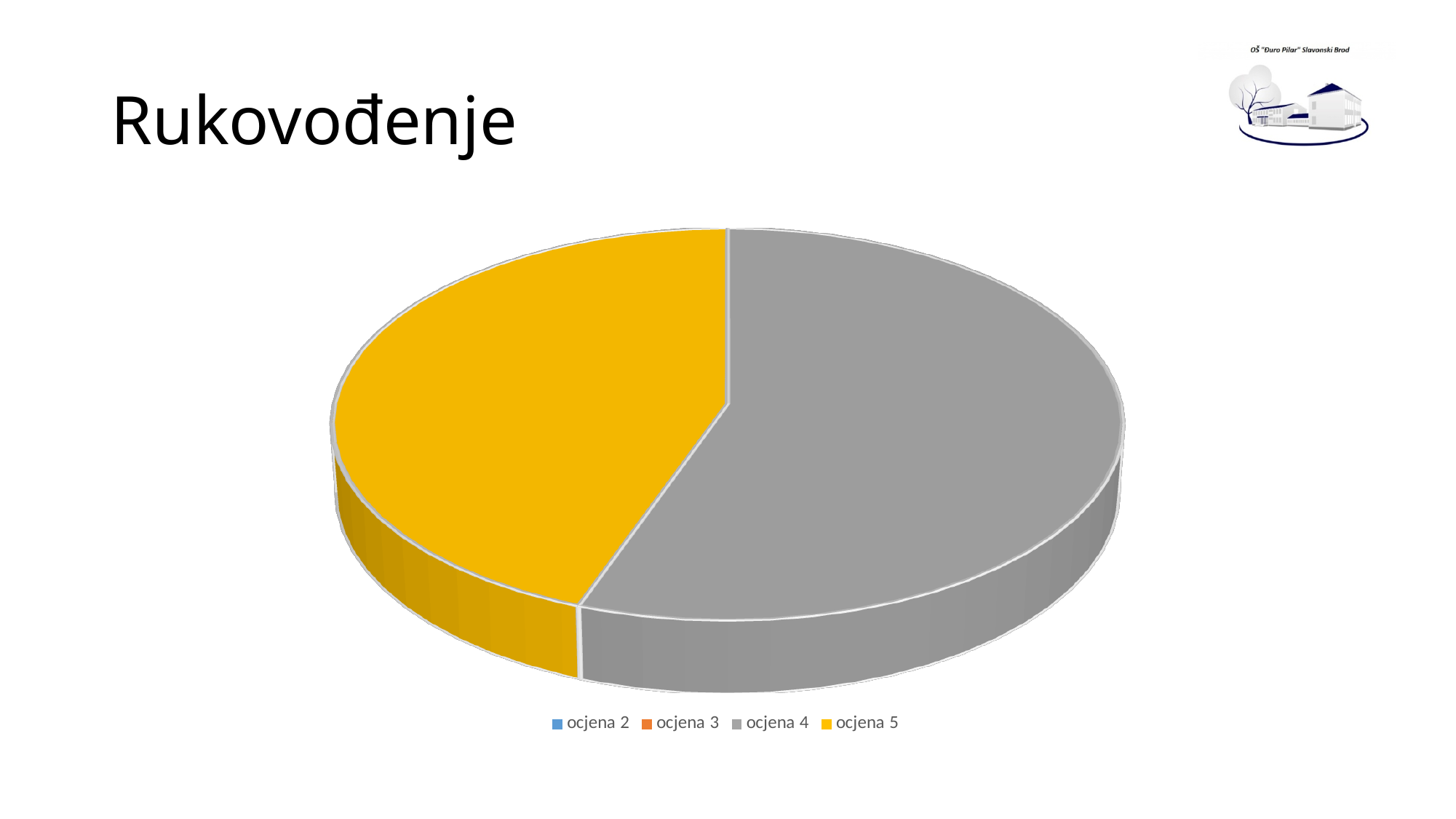
What colour is the slice for ocjena 5 in the pie chart? yellow Does the slice for ocjena 5 take up more or less than half of the pie? less What is the title of the slide containing the pie chart? Rukovođenje How many entries does the legend of the pie chart list? 4 Does the slice for ocjena 4 take up more or less than half of the pie? more What kind of chart is shown on the slide? pie chart How many slices are visible in the pie chart? 2 Which is larger in the pie chart, the slice for ocjena 4 or the slice for ocjena 5? ocjena 4 Which category has the largest slice in the pie chart? ocjena 4